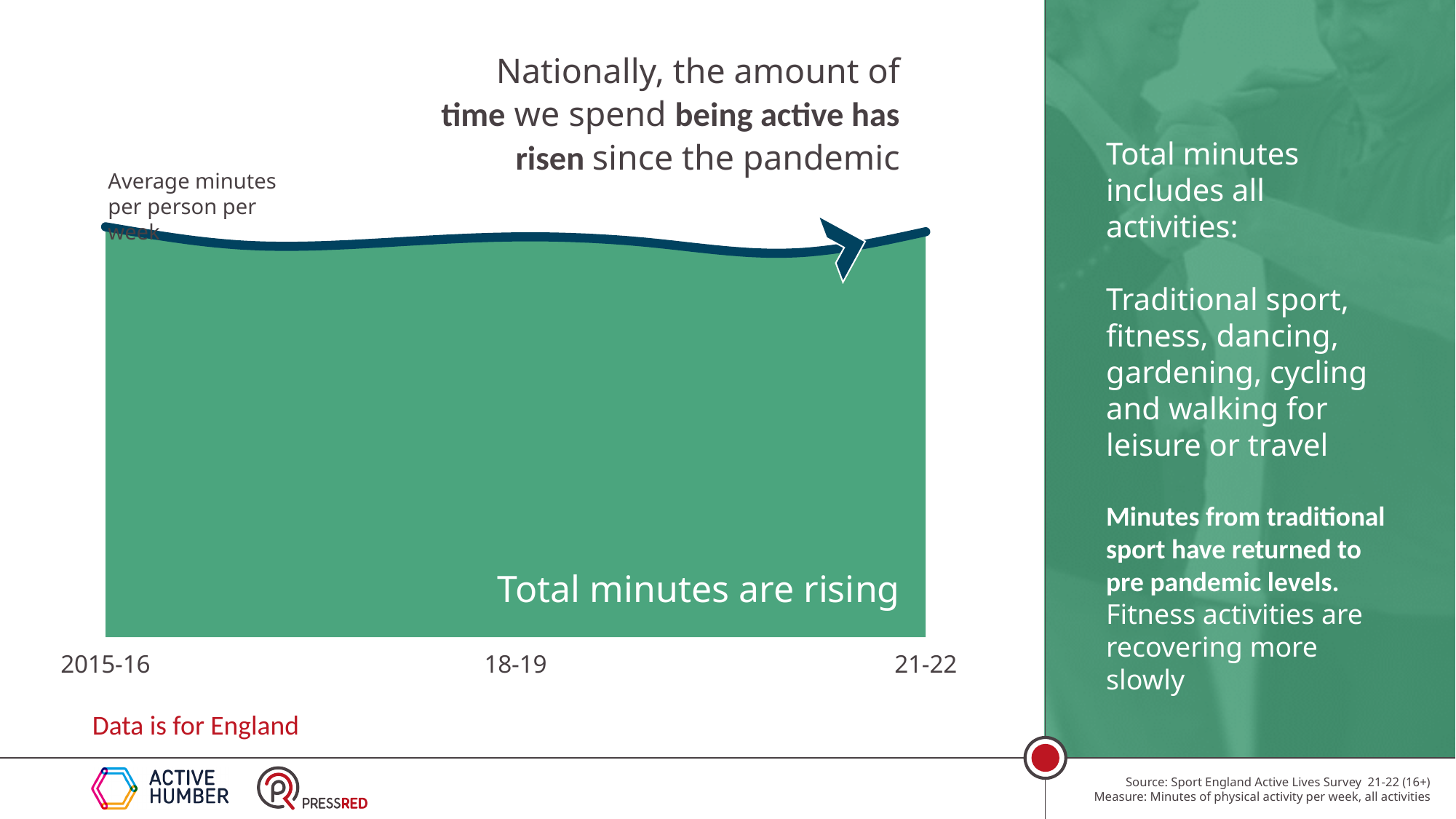
What is the last year label on the x axis of the chart? 21-22 What is the middle year label on the x axis of the chart? 18-19 What does the y axis of the chart measure, according to the label at its top left? Average minutes per person per week What is the first year label on the x axis of the chart? 2015-16 According to the caption inside the chart area, are total minutes rising or falling? rising What kind of chart is shown on the slide? area chart Which country does the chart's data cover, according to the note below the chart? England How many year labels are shown along the x axis of the chart? 3